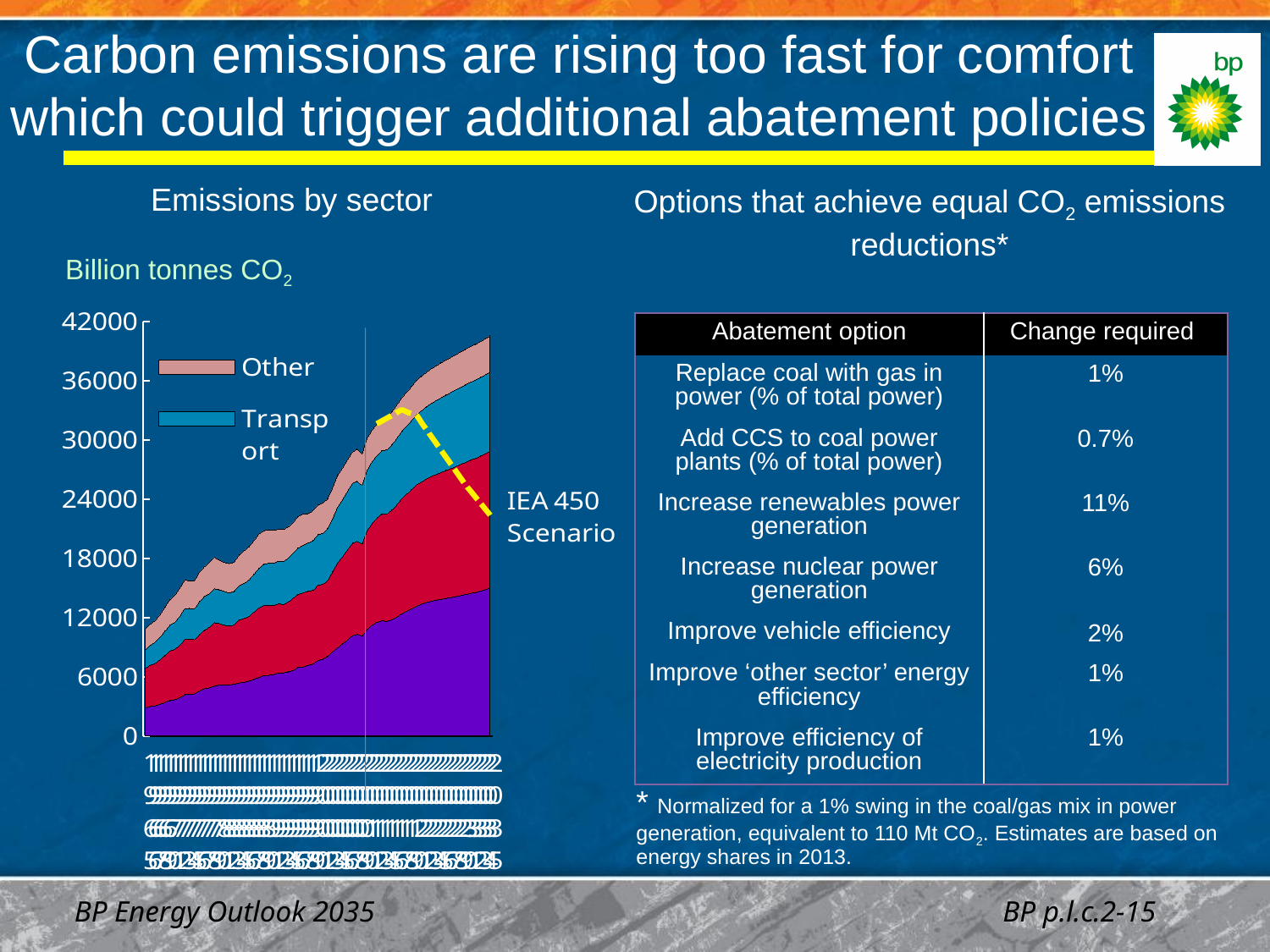
What does the dashed yellow line in the 'Emissions by sector' chart represent? IEA 450 Scenario In the 'Emissions by sector' chart, is the bottom (purple) area at the right-hand end greater or less than 12000? greater What is the highest tick value on the y axis of the 'Emissions by sector' chart? 42000 What kind of chart is shown under 'Emissions by sector'? Stacked area chart What is the title of the chart on the left of the slide? Emissions by sector What unit is shown on the y axis of the 'Emissions by sector' chart? Billion tonnes CO2 In the 'Emissions by sector' chart, is the total stacked value at the left-hand end greater or less than 12000? less In the 'Emissions by sector' chart, is the total stacked value at the right-hand end greater or less than 36000? greater In the 'Emissions by sector' chart, do total emissions rise or fall along the x axis? Rise How many coloured areas are stacked in the 'Emissions by sector' chart? 4